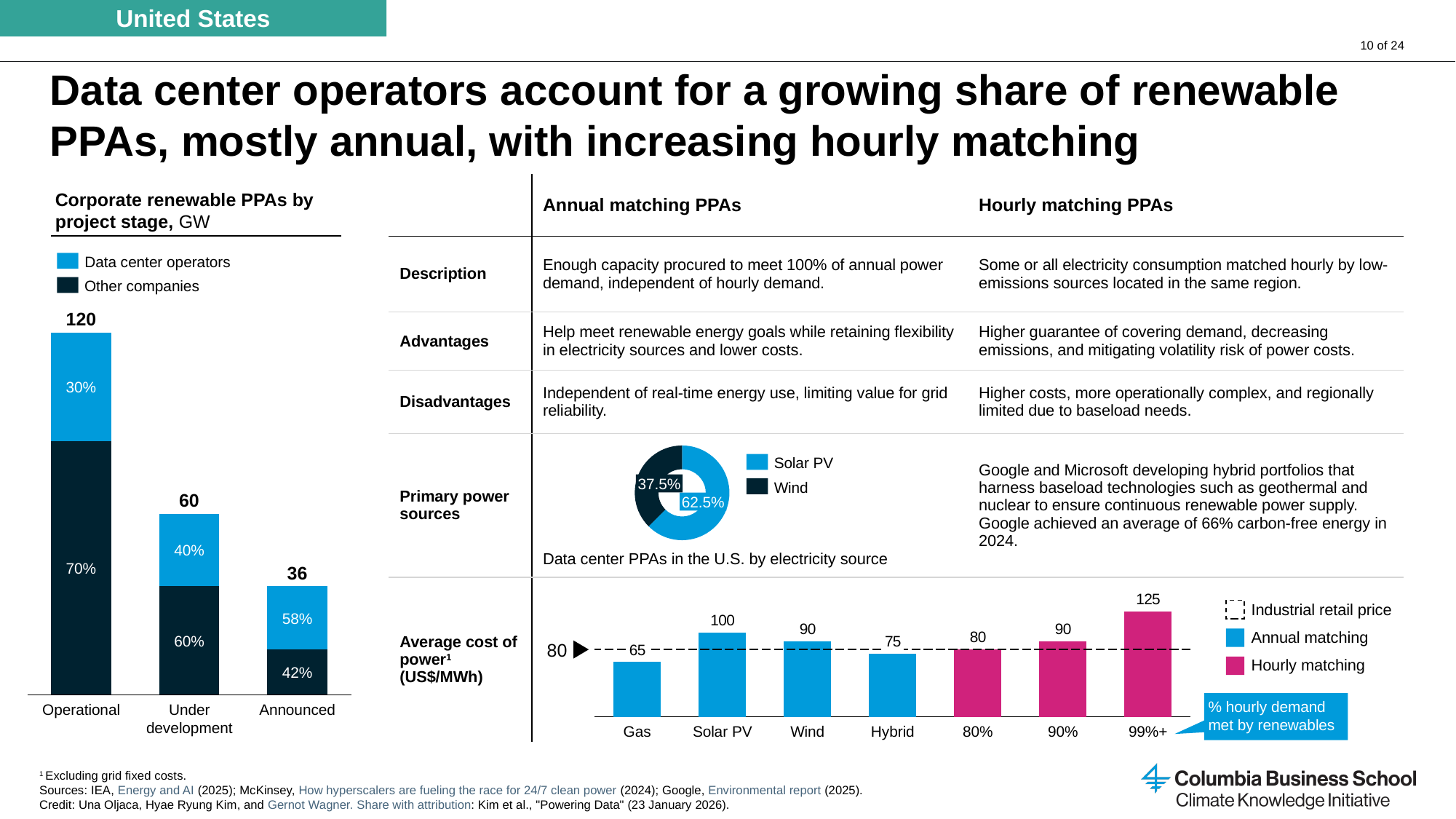
What kind of chart is 'Data center PPAs in the U.S. by electricity source'? Doughnut chart In the 'Corporate renewable PPAs by project stage' chart, what share of the Announced bar is Other companies? 42% In the 'Average cost of power' chart, how many categories are shown on the x axis? 7 In the 'Corporate renewable PPAs by project stage' chart, how many series does the legend list? 2 In the 'Average cost of power' chart, what is the difference between the 99%+ value and the Gas value? 60 In the 'Average cost of power' chart, which category has the highest value? 99%+ In the 'Average cost of power' chart, what is the value for Solar PV? 100 In the 'Data center PPAs in the U.S. by electricity source' chart, what share is Solar PV? 62.5% In the 'Corporate renewable PPAs by project stage' chart, what is the difference in total GW between Operational and Under development? 60 In the 'Corporate renewable PPAs by project stage' chart, what share of the Under development bar is Data center operators? 40% In the 'Corporate renewable PPAs by project stage' chart, which project stage has the lowest total GW? Announced In the 'Corporate renewable PPAs by project stage' chart, what is the total GW for the Operational stage? 120